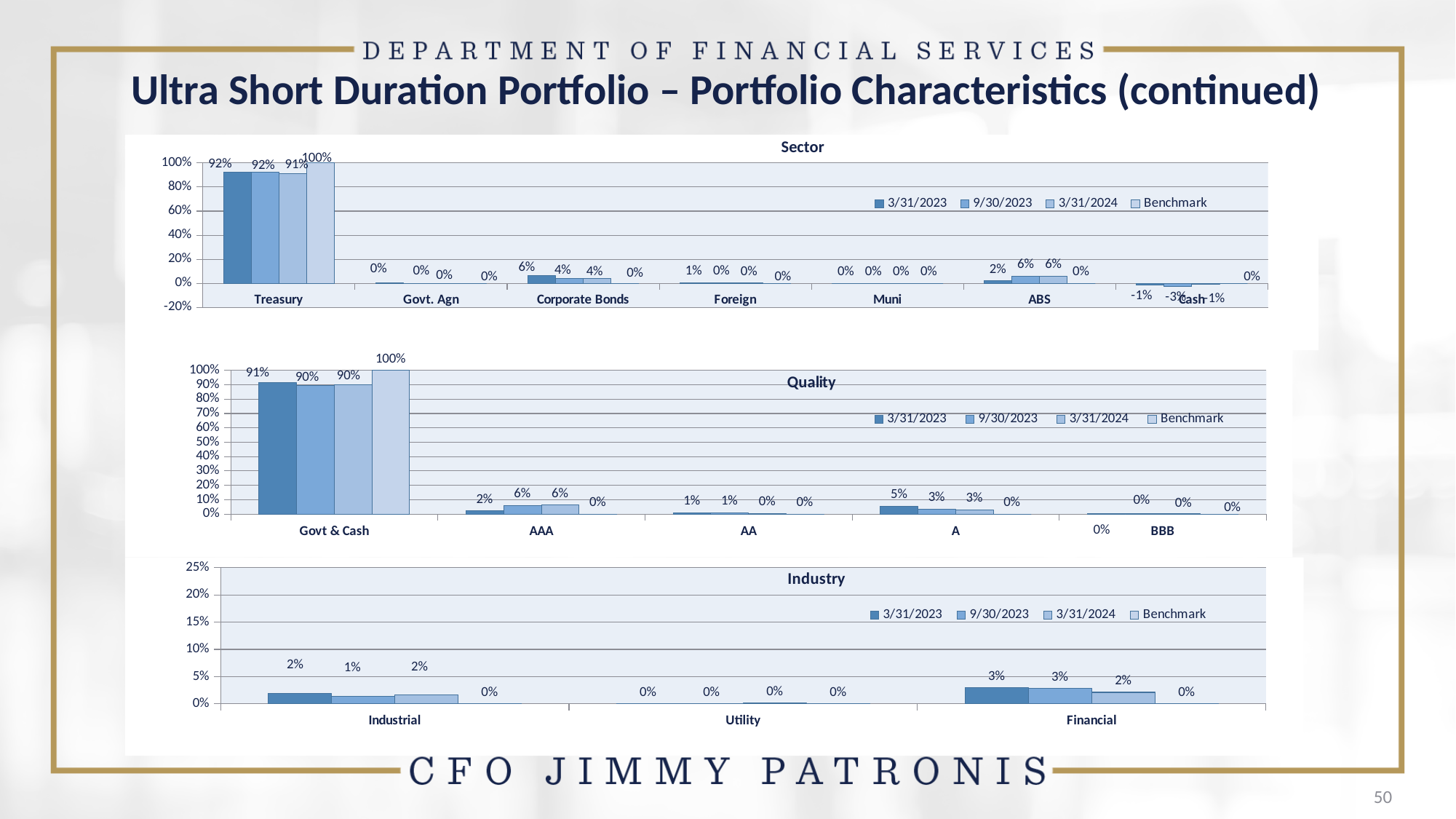
In the Sector chart, how many series does the legend list? 4 In the Quality chart, what is the Govt & Cash value for 3/31/2023? 91% In the Sector chart, which category has the highest value for 3/31/2024? Treasury In the Industry chart, which is larger for 3/31/2023: Industrial or Financial? Financial In the Industry chart, what is the Financial value for 3/31/2024? 2% What kind of chart is the Industry chart? Bar chart In the Quality chart, how many categories are shown on the x axis? 5 In the Quality chart, what is the difference between the Benchmark and 9/30/2023 values for Govt & Cash? 10% In the Sector chart, what is the Treasury value for the Benchmark series? 100% In the Quality chart, what is the value for A on 3/31/2023? 5% In the Sector chart, what is the ABS value for 9/30/2023? 6% In the Sector chart, what is the Corporate Bonds value for 3/31/2023? 6%